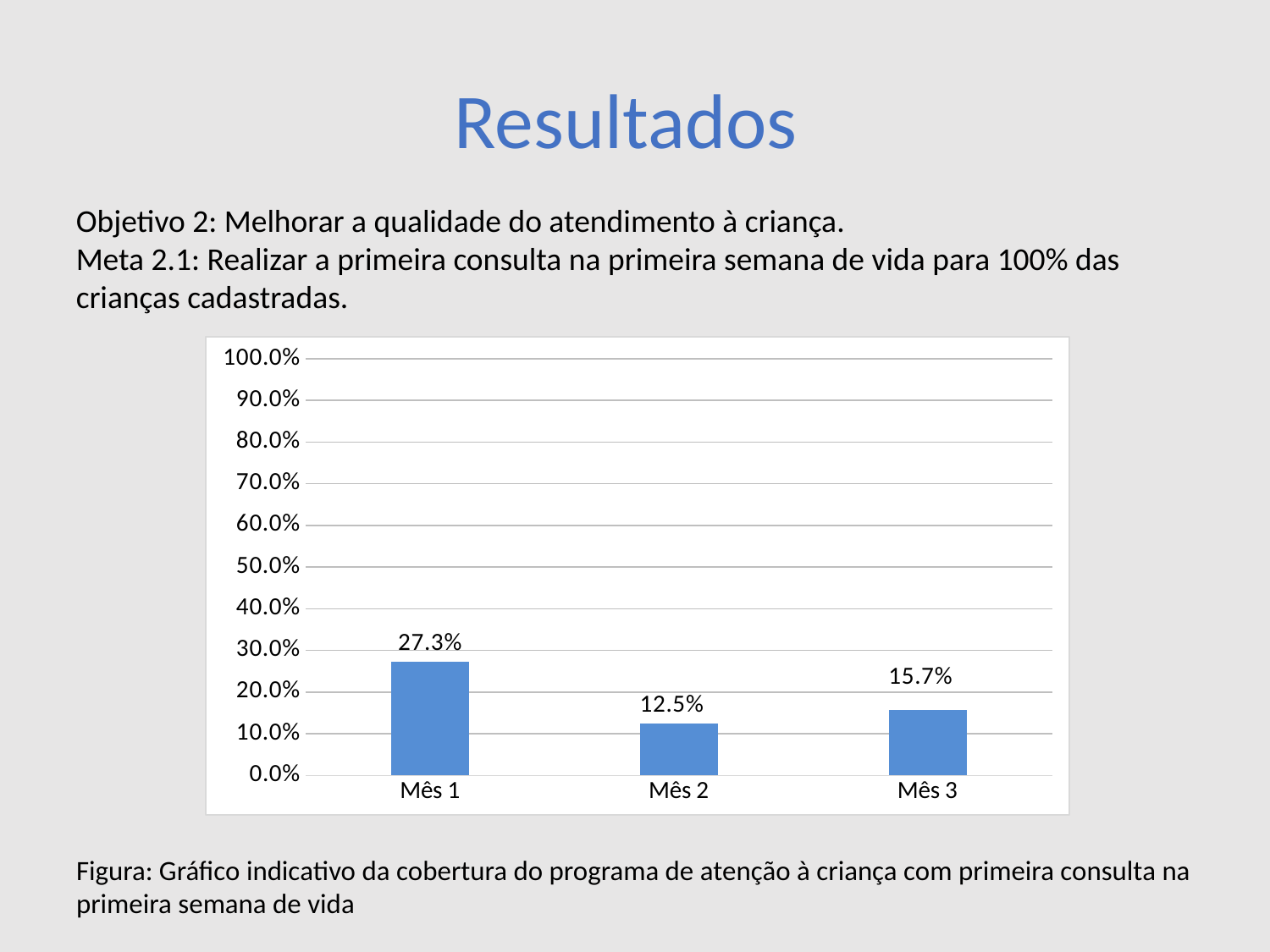
Which month has the highest value? Mês 1 What is the value for Mês 1? 27.3% Which month has the lowest value? Mês 2 Which is larger, the value for Mês 2 or the value for Mês 3? Mês 3 What is the value for Mês 3? 15.7% How many categories are shown on the x axis? 3 What kind of chart is shown on the slide? bar chart What is the value for Mês 2? 12.5% Is the value for Mês 1 greater or less than 20.0%? greater What is the maximum value shown on the y axis? 100.0% What is the difference between the values for Mês 3 and Mês 2? 3.2% What is the difference between the values for Mês 1 and Mês 2? 14.8%